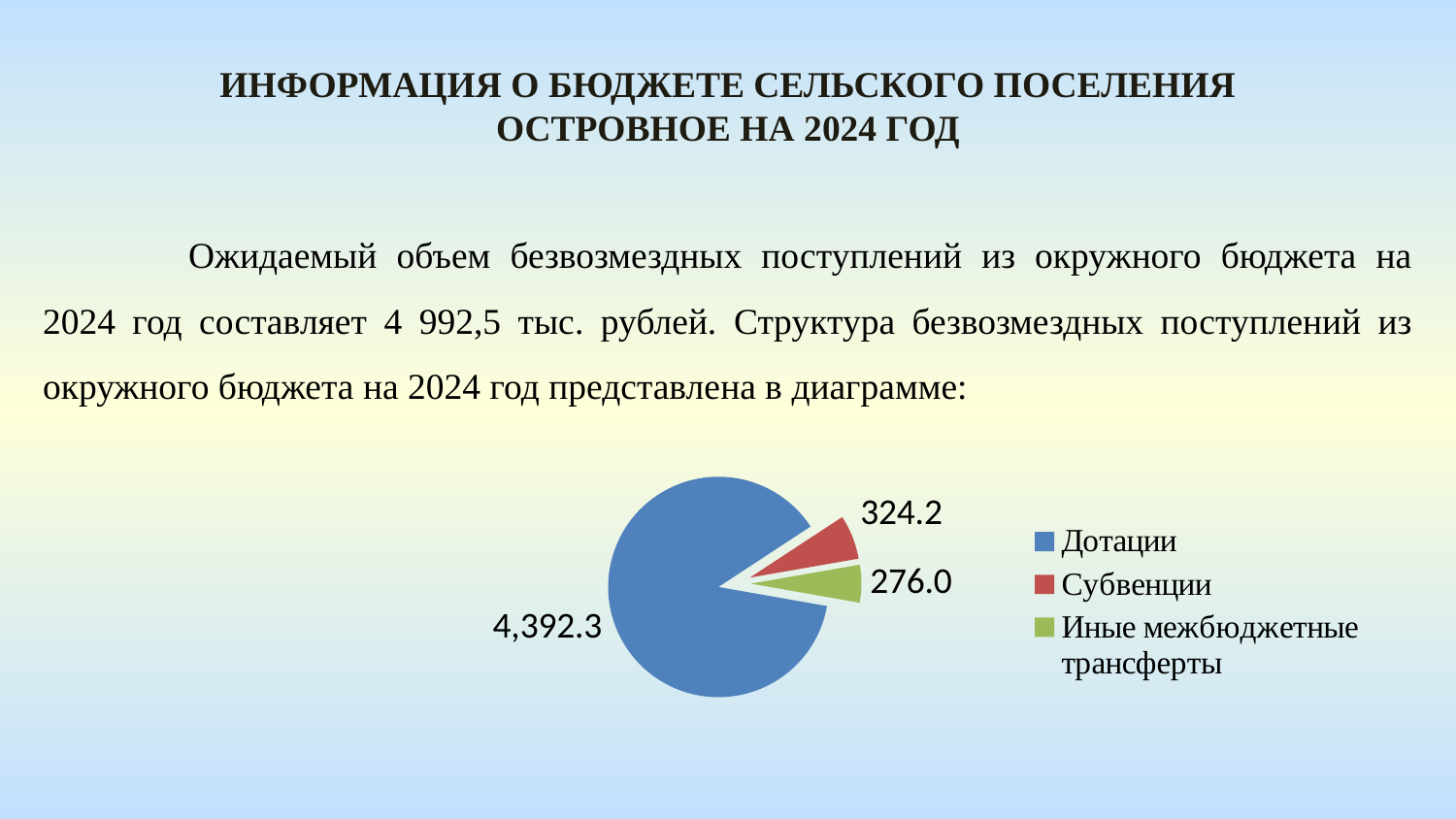
Which category has the smallest slice in the pie chart? Иные межбюджетные трансферты How many entries does the legend list? 3 What colour is the slice for Дотации? blue What is the difference between the values for Субвенции and Иные межбюджетные трансферты? 48.2 What kind of chart is shown on the slide? pie chart Which is larger, Субвенции or Иные межбюджетные трансферты? Субвенции What is the value for Иные межбюджетные трансферты in the pie chart? 276.0 How many slices does the pie chart have? 3 What is the difference between the values for Дотации and Субвенции? 4,068.1 What is the value for Субвенции in the pie chart? 324.2 Which category has the largest slice in the pie chart? Дотации What is the value for Дотации in the pie chart? 4,392.3